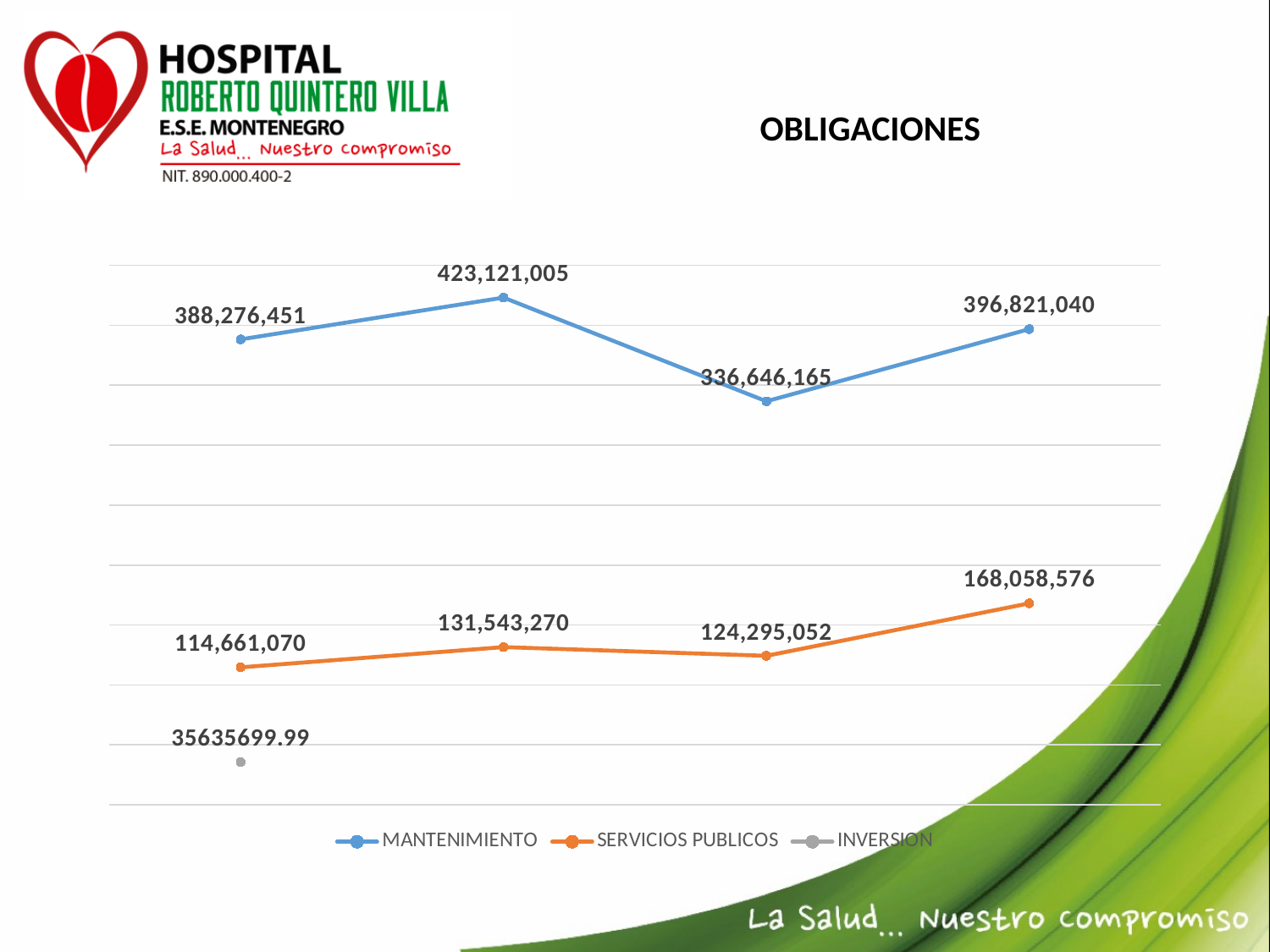
Which point of the MANTENIMIENTO series has the lowest value? 336,646,165 (third point) What is the value of the second point of the MANTENIMIENTO series? 423,121,005 What kind of chart is shown on the slide? line chart What is the value of the last point of the SERVICIOS PUBLICOS series? 168,058,576 Does the MANTENIMIENTO series rise or fall from its second point to its third point? fall What is the value shown for the INVERSION series? 35635699.99 Which is larger: the first value of MANTENIMIENTO or the first value of SERVICIOS PUBLICOS? MANTENIMIENTO (388,276,451) Which point of the SERVICIOS PUBLICOS series has the highest value? 168,058,576 (fourth point) What is the title of the chart? OBLIGACIONES How many data points are plotted for the MANTENIMIENTO series? 4 How many series does the legend list? 3 What is the difference between the second and first values of the MANTENIMIENTO series? 34,844,554